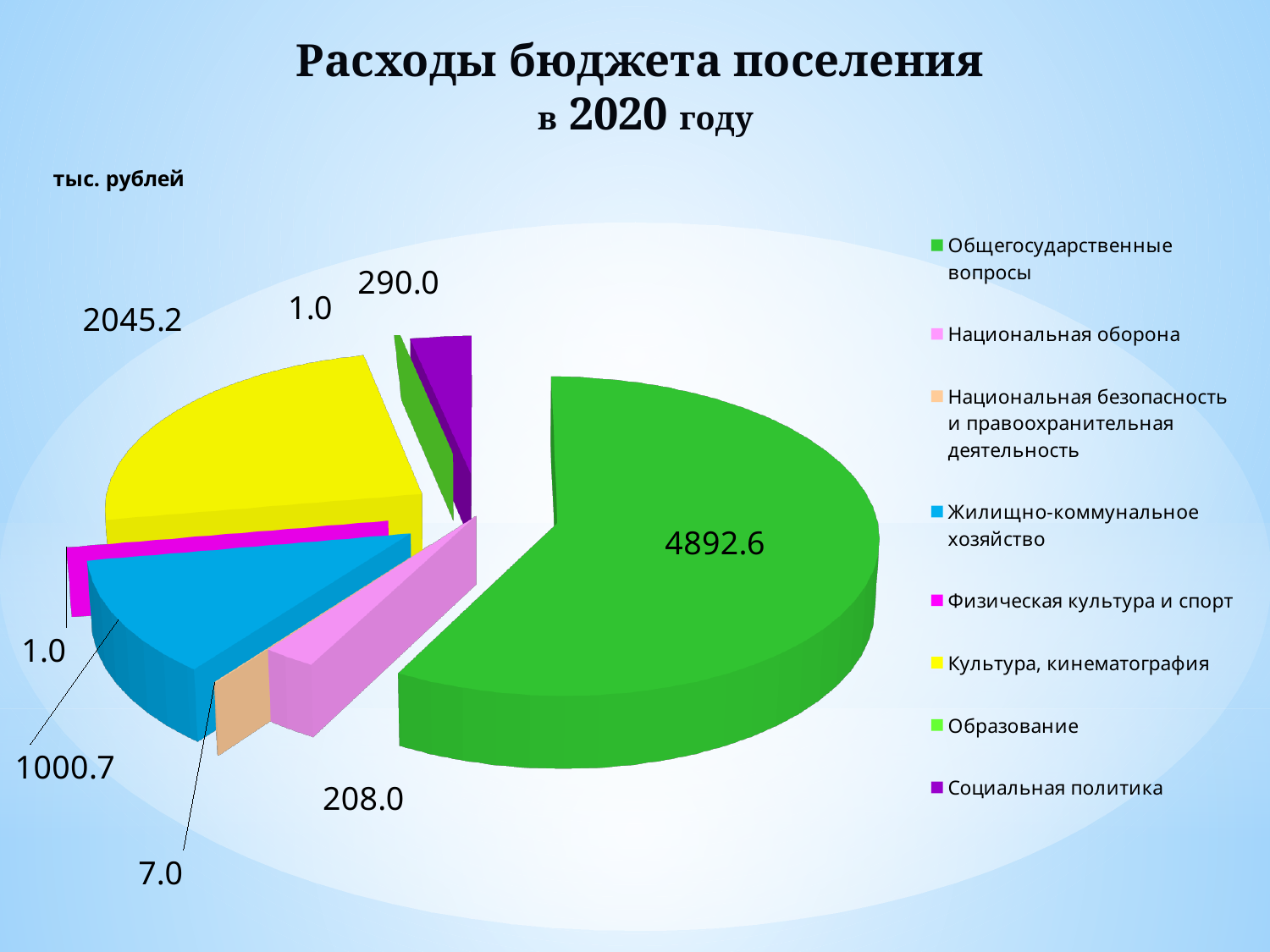
Which category has the largest share of the pie? Общегосударственные вопросы What unit is stated for the values on the chart? тыс. рублей How many categories does the legend list? 8 What is the value for Общегосударственные вопросы? 4892.6 What is the value for Социальная политика? 290.0 What type of chart is shown on the slide? Pie chart What is the difference between the values for Социальная политика and Национальная оборона? 82.0 What is the value for Национальная безопасность и правоохранительная деятельность? 7.0 What is the difference between the values for Культура, кинематография and Жилищно-коммунальное хозяйство? 1044.5 What is the value for Жилищно-коммунальное хозяйство? 1000.7 What is the value for Культура, кинематография? 2045.2 Which is larger, the value for Национальная оборона or the value for Социальная политика? Социальная политика